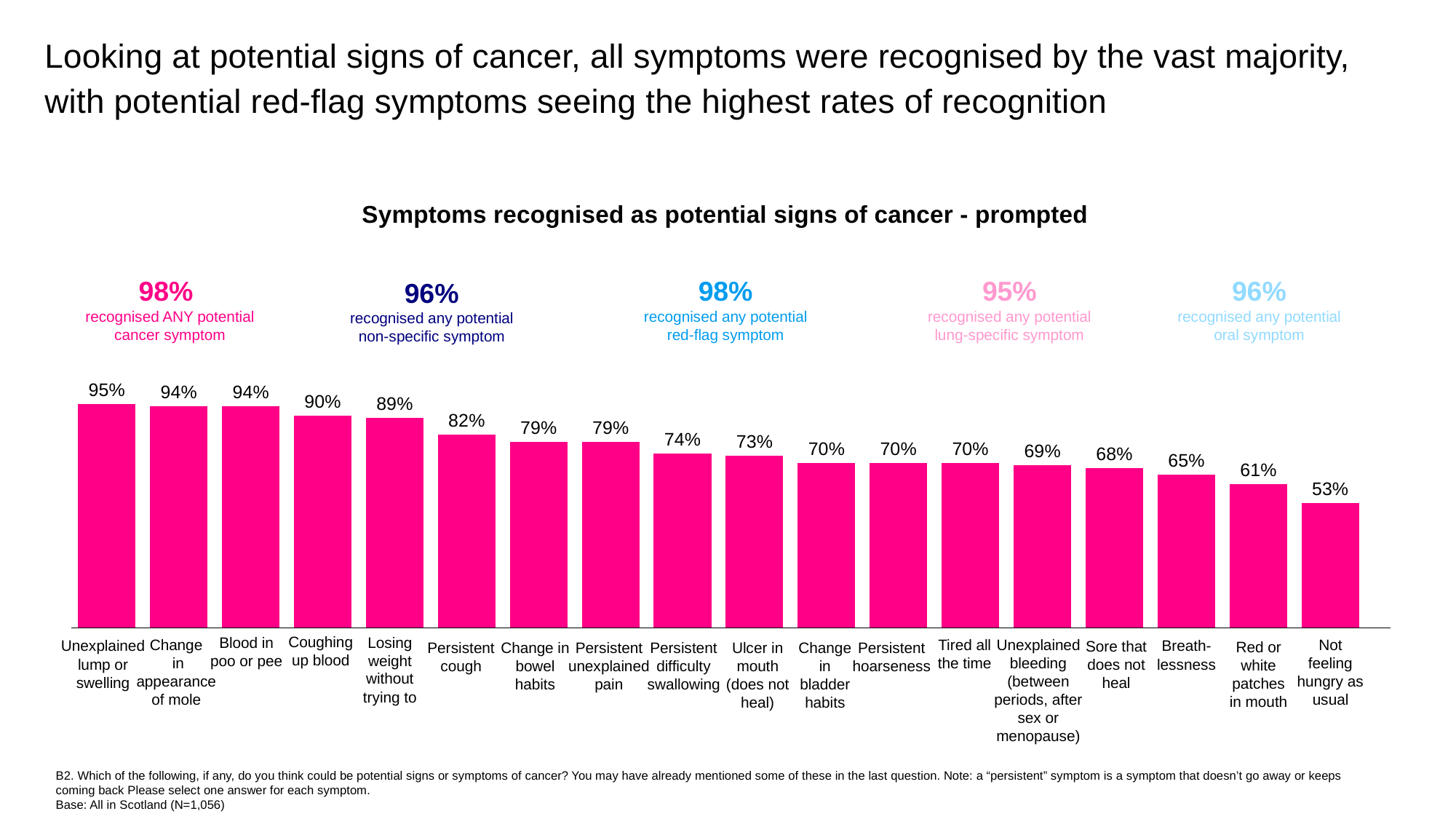
According to the summary figures above the chart, what percentage recognised any potential red-flag symptom? 98% How many symptoms (bars) are shown in the chart? 18 What percentage recognised 'Not feeling hungry as usual' as a potential sign of cancer? 53% What type of chart is used to show the symptom recognition rates? Bar chart What is the value shown for 'Persistent cough'? 82% Do the values rise or fall moving from left to right across the chart? Fall What percentage recognised 'Unexplained lump or swelling' as a potential sign of cancer? 95% Which has a higher value: 'Persistent difficulty swallowing' or 'Ulcer in mouth (does not heal)'? Persistent difficulty swallowing Which symptom has the highest recognition rate in the chart? Unexplained lump or swelling What is the title of the chart? Symptoms recognised as potential signs of cancer - prompted Which symptom has the lowest recognition rate in the chart? Not feeling hungry as usual What is the difference between the values for 'Coughing up blood' and 'Breathlessness'? 25 percentage points